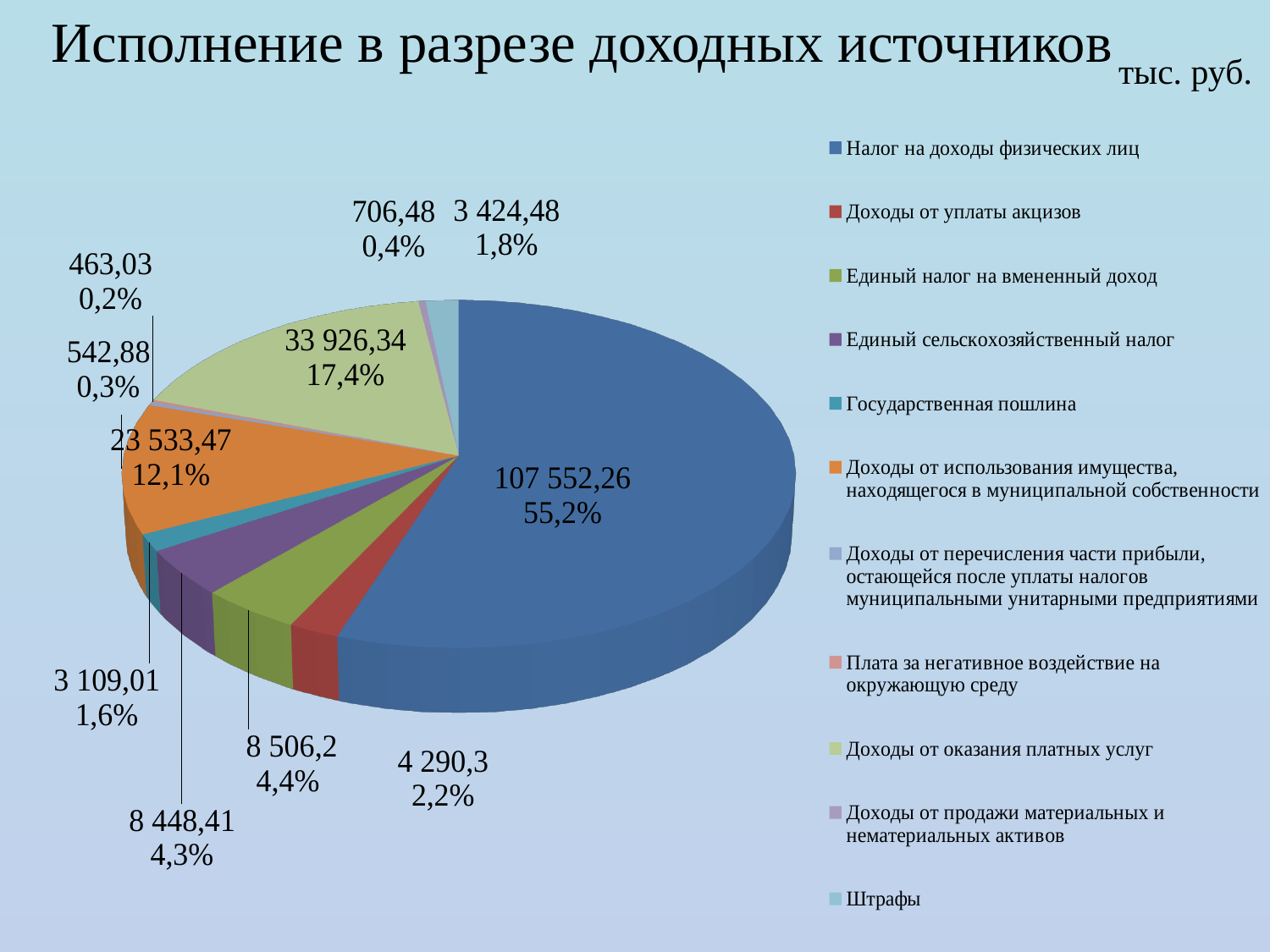
What is the value for Доходы от оказания платных услуг? 33 926,34 What unit is indicated in the top right corner of the slide? тыс. руб. What share of the pie does Доходы от использования имущества, находящегося в муниципальной собственности take? 12,1% What is the value for Налог на доходы физических лиц? 107 552,26 What is the difference between the values for Доходы от оказания платных услуг and Доходы от использования имущества, находящегося в муниципальной собственности? 10 392,87 What kind of chart is shown on the slide? pie chart How many categories does the legend list? 11 What is the value for Единый налог на вмененный доход? 8 506,2 Which category has the largest slice of the pie? Налог на доходы физических лиц Which is larger, Доходы от уплаты акцизов or Государственная пошлина? Доходы от уплаты акцизов What share of the pie does Налог на доходы физических лиц take? 55,2% What is the smallest value shown on the pie chart? 463,03